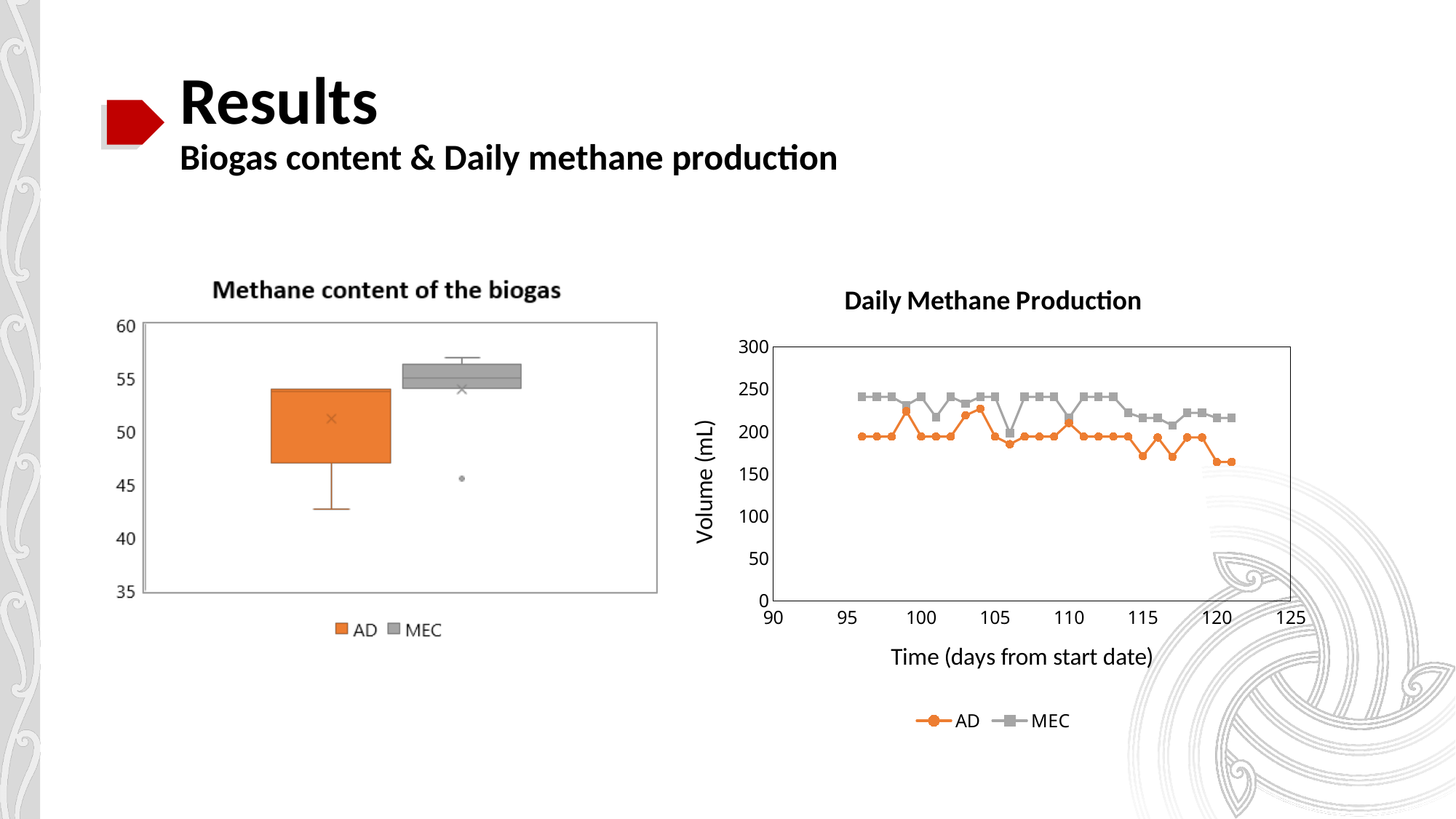
In the "Daily Methane Production" chart, does the AD series rise or fall between day 115 and day 121? fall In the "Methane content of the biogas" chart, how many series does the legend list? 2 What kind of chart is the "Methane content of the biogas" chart? box plot In the "Daily Methane Production" chart, how many series does the legend list? 2 In the "Daily Methane Production" chart, which series is generally higher, AD or MEC? MEC In the "Methane content of the biogas" chart, is the MEC box entirely greater or less than 50? greater In the "Daily Methane Production" chart, is the AD value at day 121 greater or less than 200? less In the "Daily Methane Production" chart, is the MEC value at day 121 greater or less than 250? less In the "Methane content of the biogas" chart, which group has the higher box, AD or MEC? MEC What is the y-axis label of the "Daily Methane Production" chart? Volume (mL) What kind of chart is the "Daily Methane Production" chart? line chart